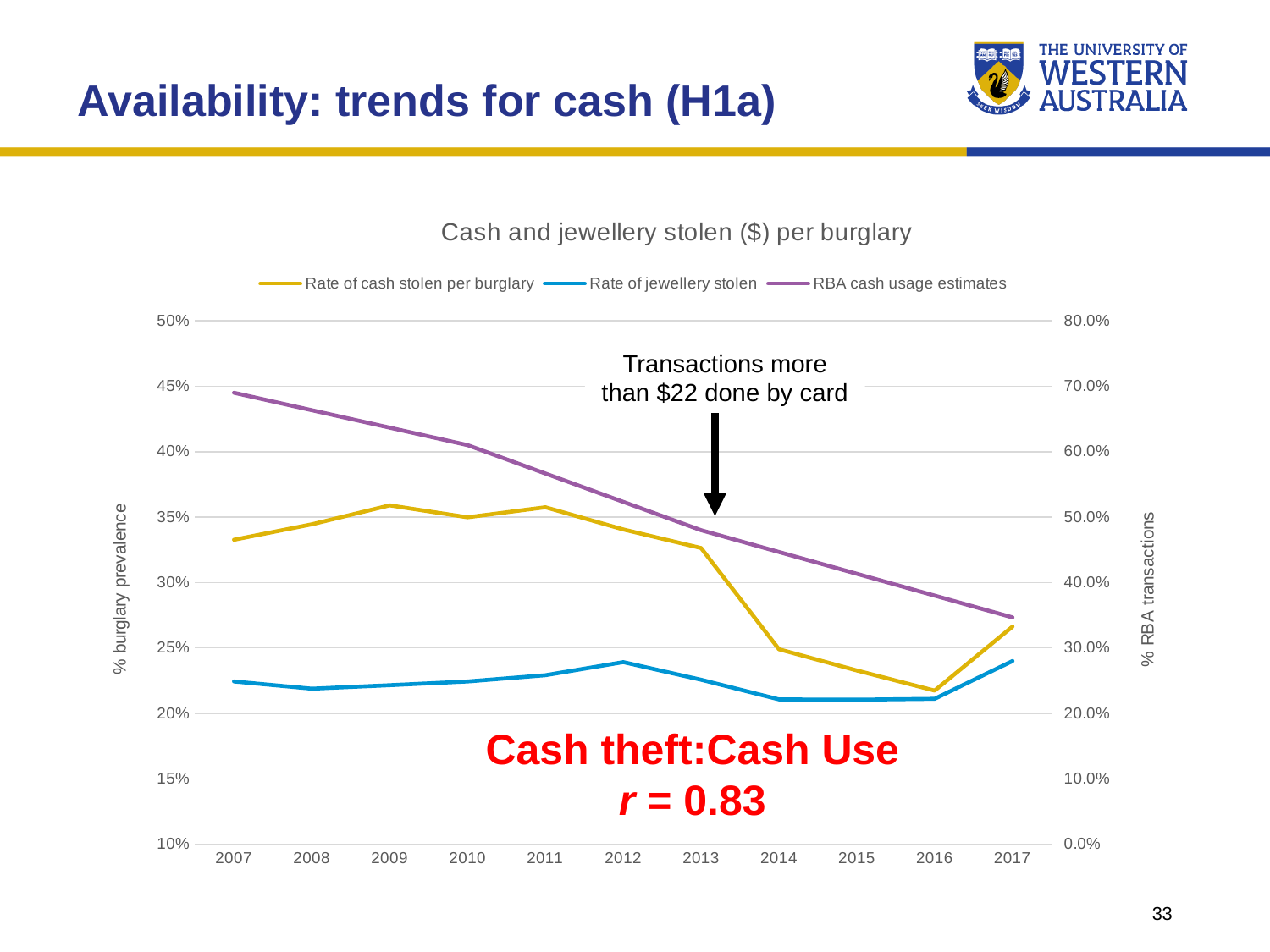
How many years are plotted along the x axis? 11 Is the rate of cash stolen per burglary in 2014 greater or less than 30%? less Is the rate of jewellery stolen in 2012 greater or less than 25%? less In which year is the RBA cash usage estimates series highest? 2007 In which year is the RBA cash usage estimates series lowest? 2017 How many series does the legend list? 3 Is the RBA cash usage estimate for 2007 greater or less than 60.0% on the right axis? greater In 2007, which is higher: the rate of cash stolen per burglary or the rate of jewellery stolen? Rate of cash stolen per burglary What kind of chart is shown on the slide? line chart In which year is the rate of cash stolen per burglary lowest? 2016 What is the title of the chart? Cash and jewellery stolen ($) per burglary Does the RBA cash usage estimates series rise or fall from 2007 to 2017? fall